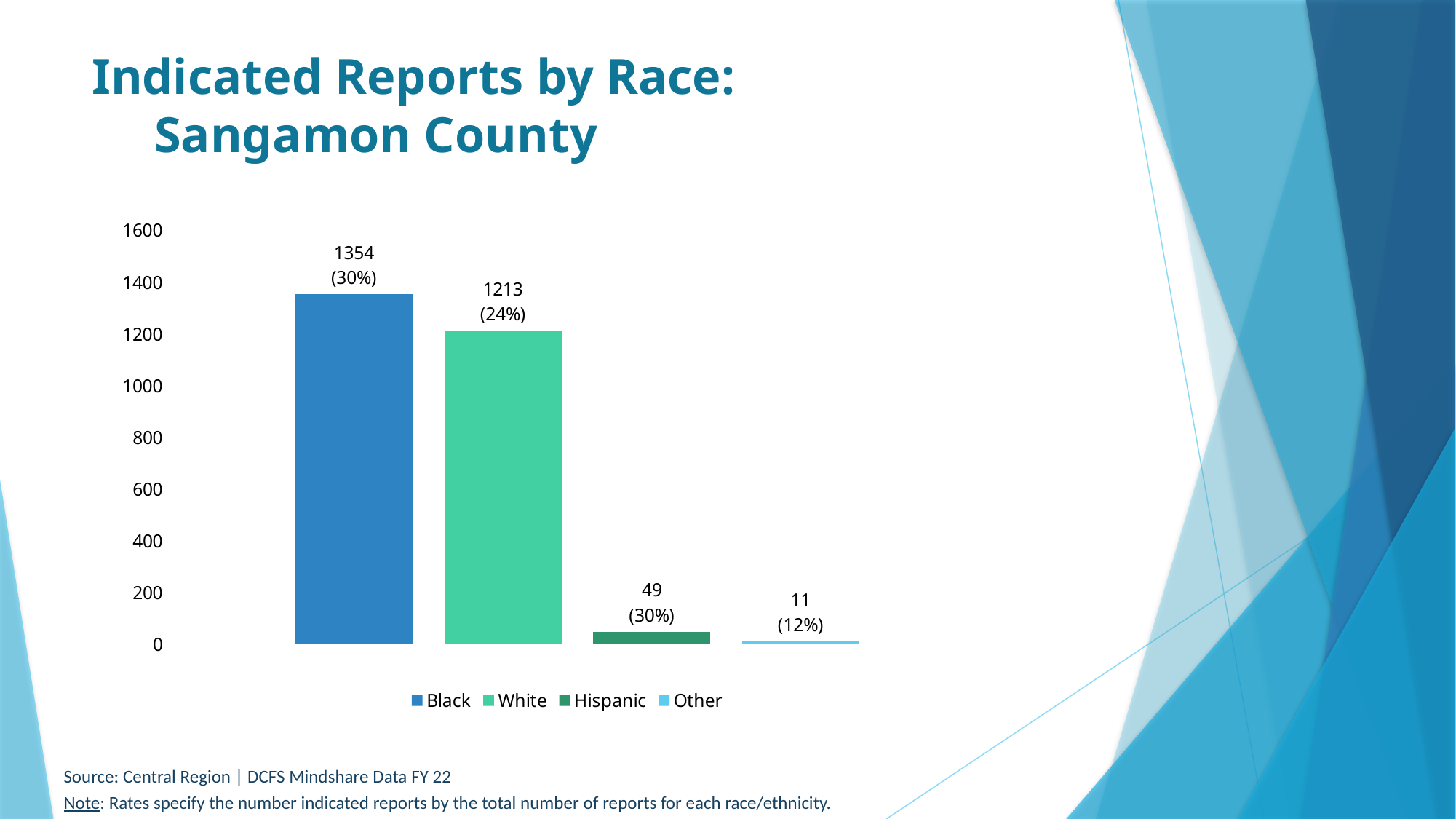
What is the number of indicated reports for Hispanic? 49 What is the number of indicated reports for White? 1213 What is the difference between the number of indicated reports for Black and White? 141 Which race/ethnicity has the highest number of indicated reports? Black What rate is shown in parentheses for Other? 12% What is the number of indicated reports for Other? 11 Which has more indicated reports, Hispanic or Other? Hispanic What is the number of indicated reports for Black? 1354 What kind of chart is shown on the slide? Bar chart How many race/ethnicity categories does the legend list? 4 Which race/ethnicity has the lowest number of indicated reports? Other What rate is shown in parentheses for White? 24%